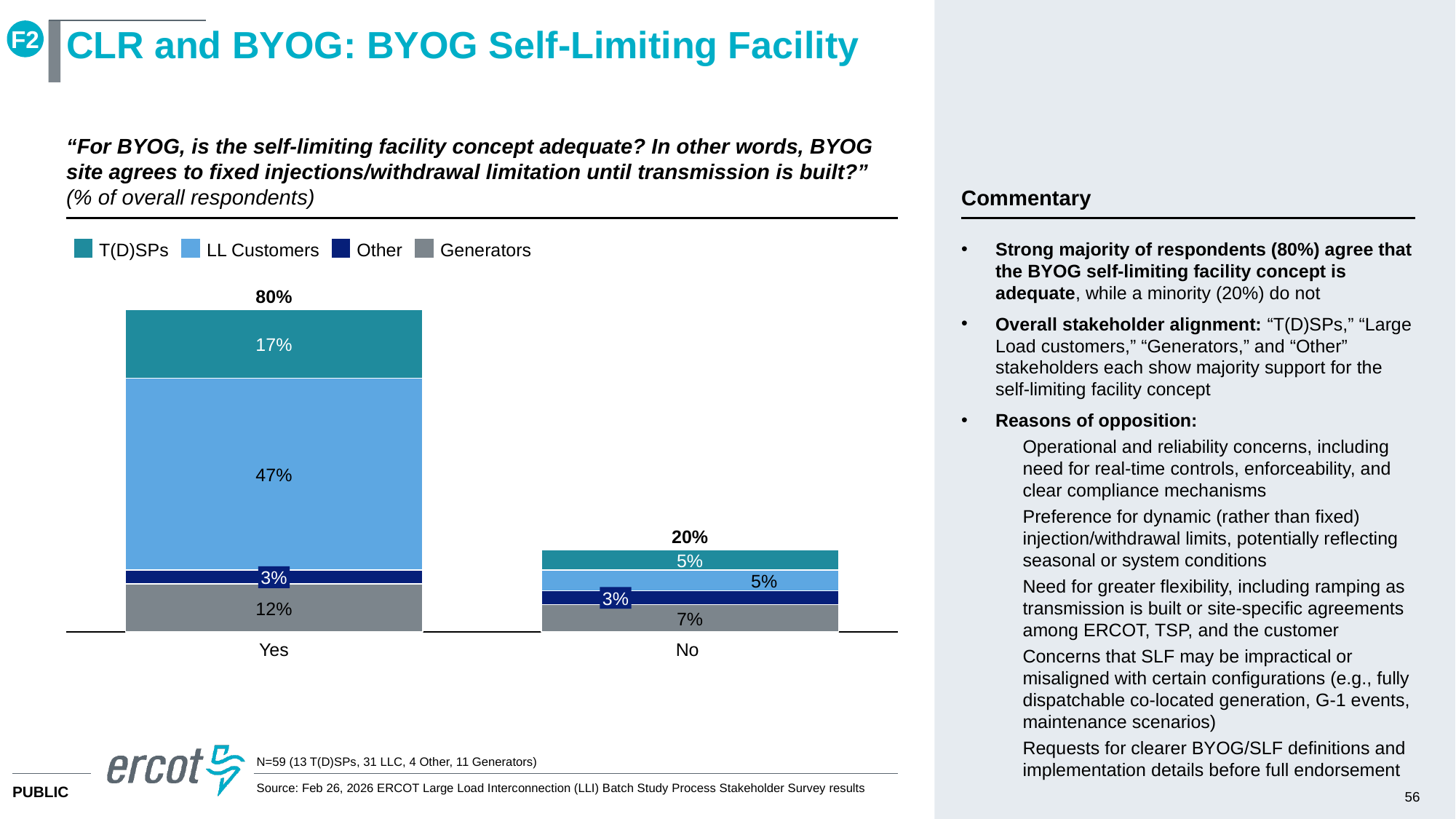
Which series has the largest segment in the "Yes" bar? LL Customers What is the value for T(D)SPs in the "No" bar? 5% What is the total for the "Yes" bar? 80% How many series does the legend list? 4 Which series has the smallest segment in the "No" bar? Other What is the value for LL Customers in the "Yes" bar? 47% What type of chart is shown on the slide? Stacked bar chart What is the total for the "No" bar? 20% What is the difference between the T(D)SPs values for "Yes" and "No"? 12% What is the value for Generators in the "Yes" bar? 12% Which is larger: the Generators value for "Yes" or the Generators value for "No"? Yes How many categories are shown on the x axis? 2